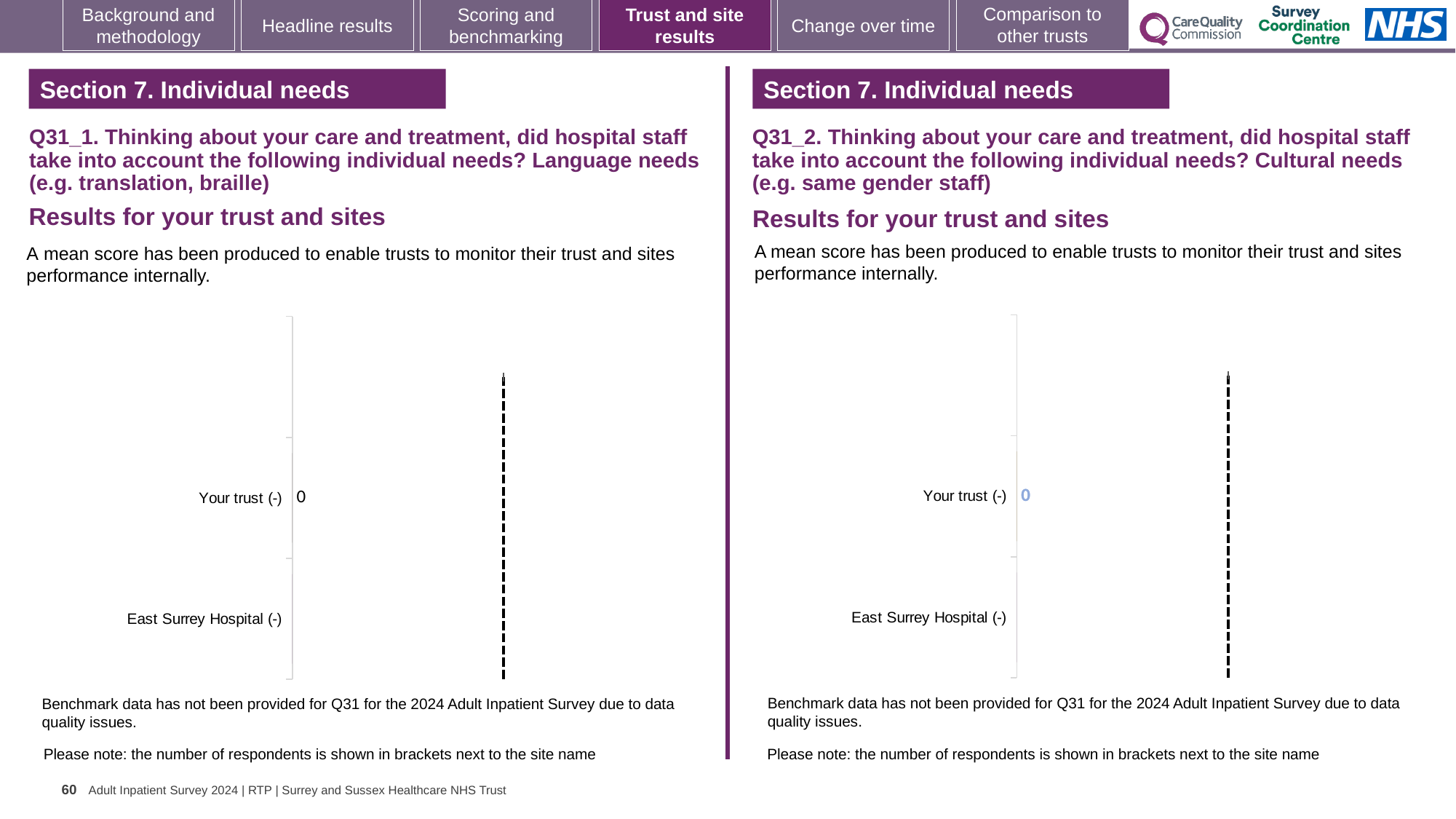
On the left chart (Q31_1, Language needs), which site is listed below Your trust? East Surrey Hospital (-) On the right chart (Q31_2, Cultural needs), what value is shown for Your trust? 0 How many categories are listed on the left chart (Q31_1, Language needs)? 2 How many charts are shown on the slide? 2 How many categories are listed on the right chart (Q31_2, Cultural needs)? 2 On the left chart (Q31_1, Language needs), what value is shown for Your trust? 0 On the right chart (Q31_2, Cultural needs), what is the label of the first category? Your trust (-)